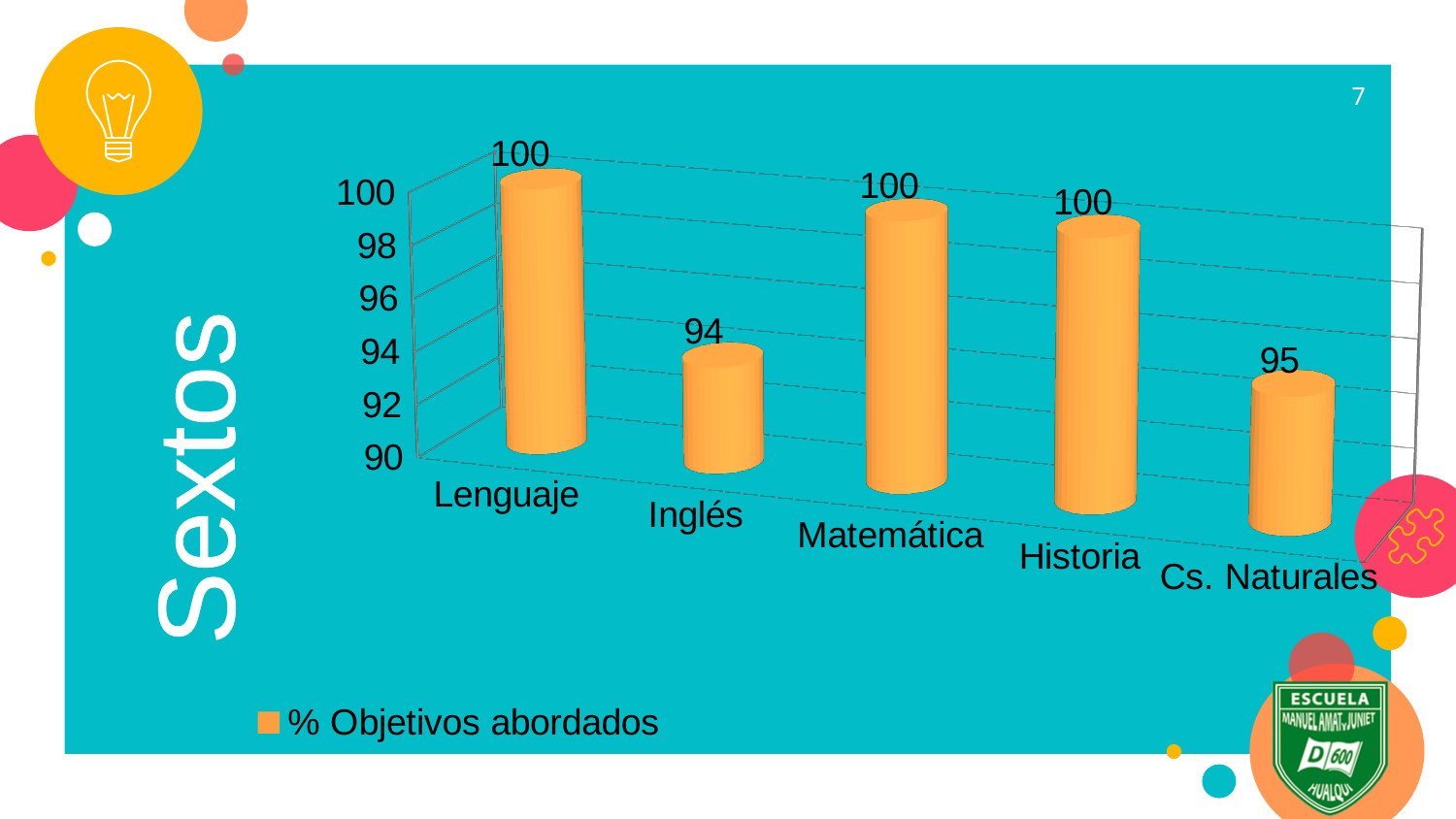
Which is larger, the value for Historia or the value for Cs. Naturales? Historia What is the difference between the values for Cs. Naturales and Inglés? 1 What is the value for Lenguaje? 100 What is the difference between the values for Matemática and Inglés? 6 How many series does the legend list? 1 What is the value for Cs. Naturales? 95 What is the value for Inglés? 94 How many categories are shown on the x axis? 5 Which category has the lowest value? Inglés What is the legend entry for the series? % Objetivos abordados What is the value for Historia? 100 What kind of chart is shown? bar chart